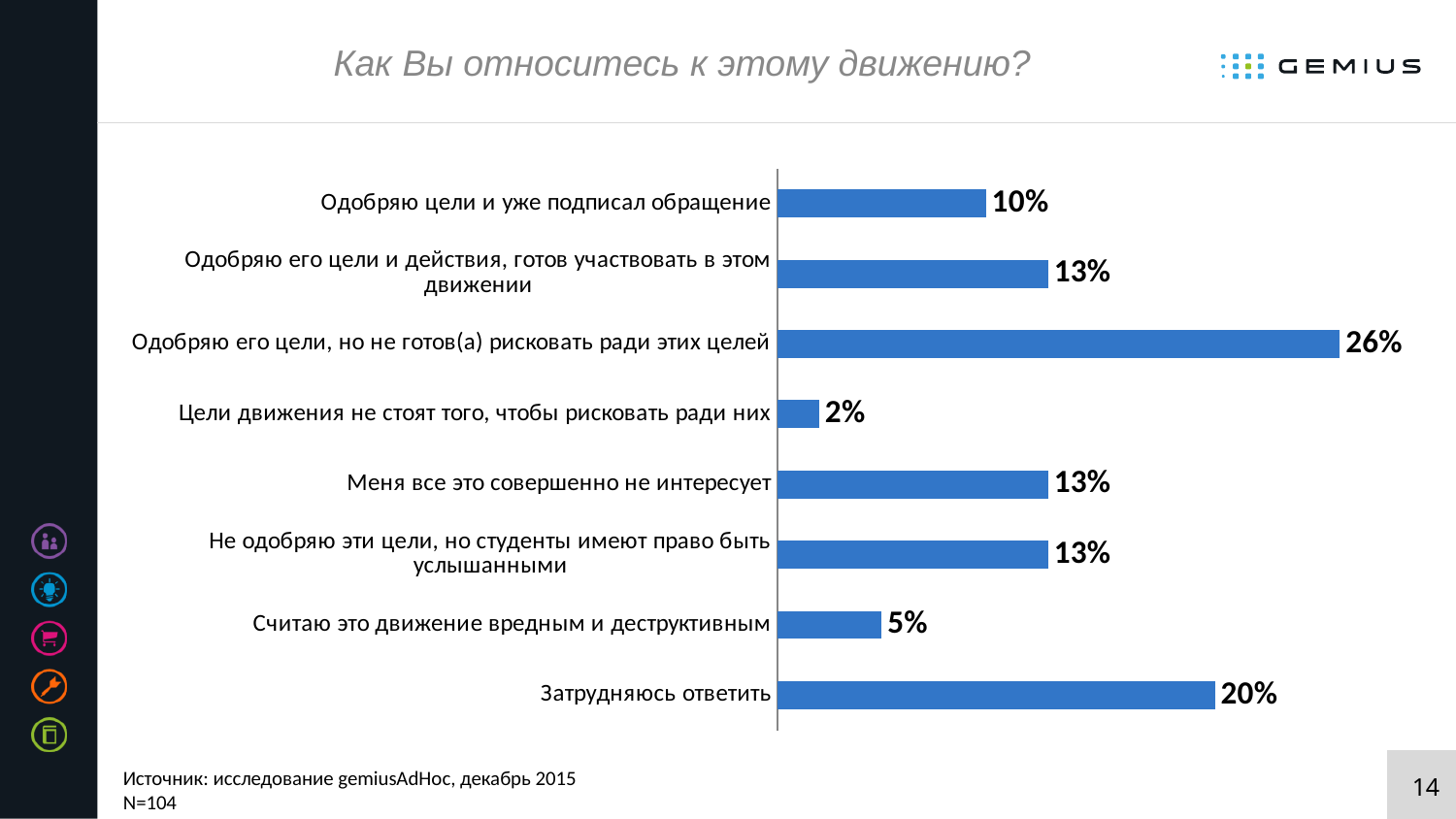
What is the value for "Цели движения не стоят того, чтобы рисковать ради них"? 2% What is the value for "Одобряю цели и уже подписал обращение"? 10% How many categories are shown in the chart? 8 What is the difference between "Одобряю его цели, но не готов(а) рисковать ради этих целей" and "Затрудняюсь ответить"? 6% Which is larger: "Одобряю цели и уже подписал обращение" or "Меня все это совершенно не интересует"? Меня все это совершенно не интересует How many categories have a value of 13%? 3 Which category has the lowest value? Цели движения не стоят того, чтобы рисковать ради них Which category has the highest value? Одобряю его цели, но не готов(а) рисковать ради этих целей What is the value for "Считаю это движение вредным и деструктивным"? 5% What is the title of the chart? Как Вы относитесь к этому движению? What kind of chart is shown on the slide? Bar chart What is the value for "Затрудняюсь ответить"? 20%